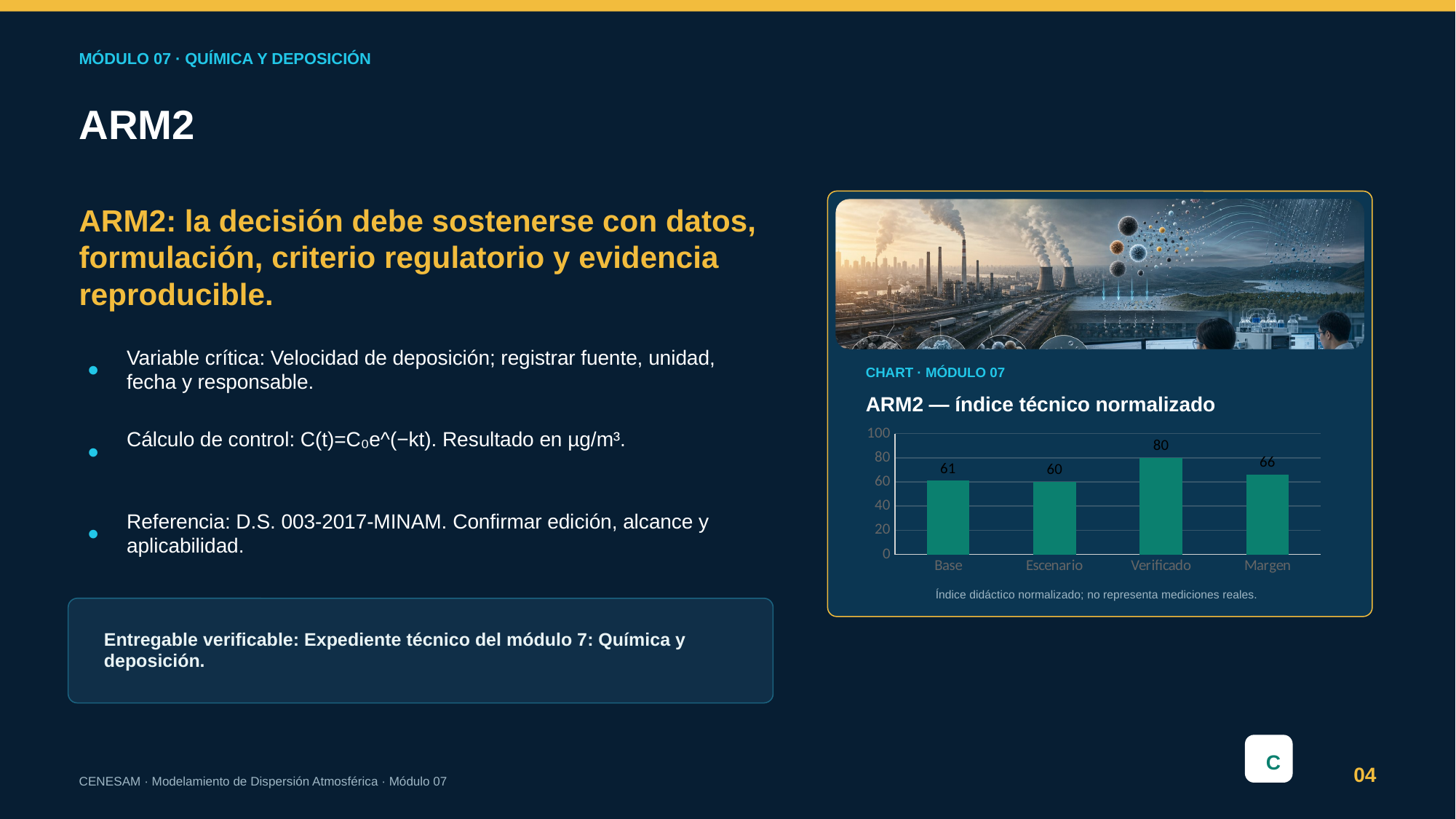
How many categories are shown on the x axis of the chart? 4 Which category has the highest value in the chart? Verificado What is the title of the chart? ARM2 — índice técnico normalizado What is the value for Margen in the chart? 66 Is the value for Verificado greater or less than 60? greater What kind of chart is shown on the slide? Bar chart What is the value for Verificado in the chart? 80 Which is larger, the value for Margen or the value for Base? Margen What is the value for Base in the chart? 61 What is the value for Escenario in the chart? 60 What is the difference between the values for Verificado and Escenario? 20 Which category has the lowest value in the chart? Escenario